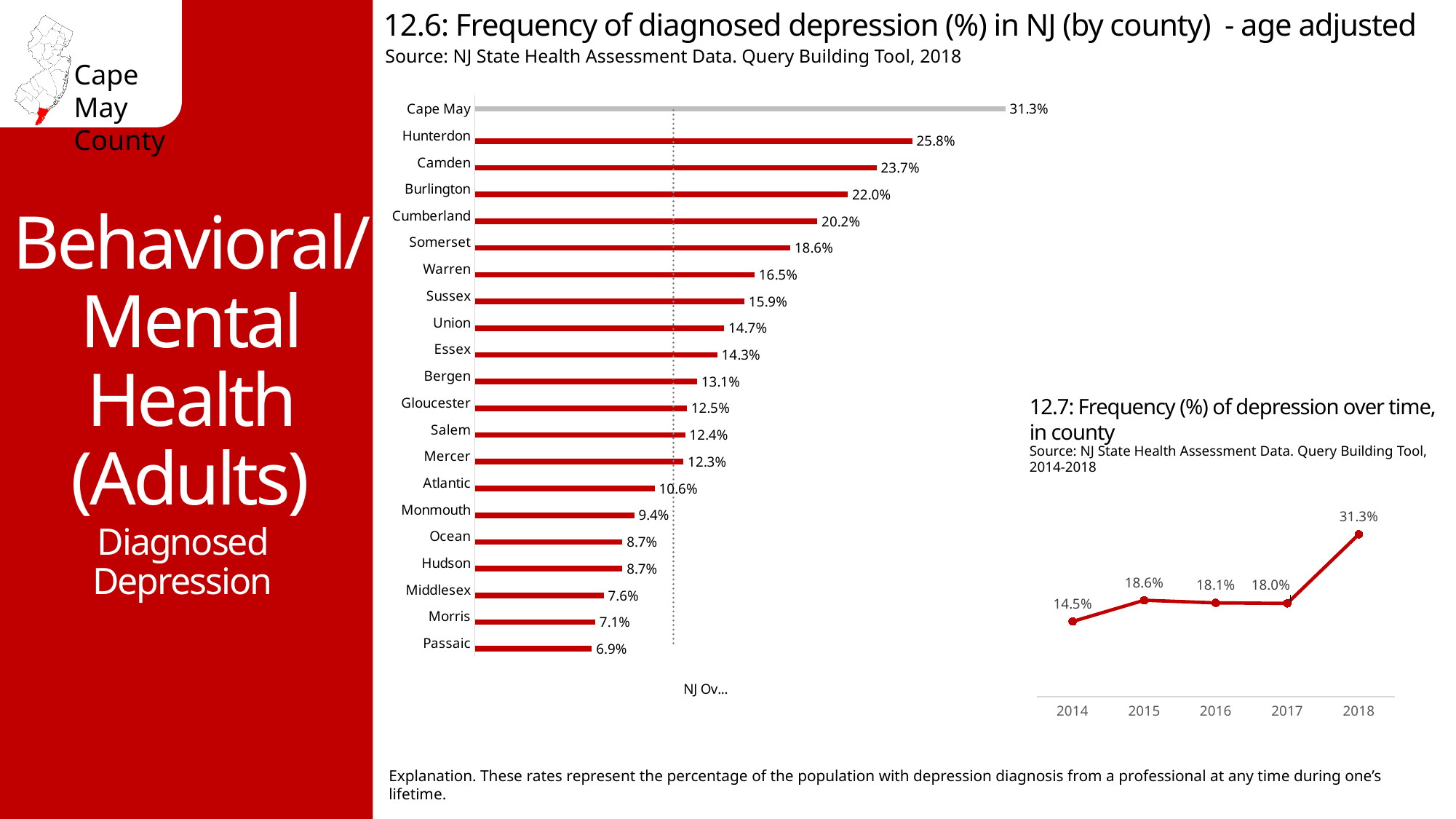
What kind of chart is chart 12.7 (frequency of depression over time)? Line chart In chart 12.7 (frequency of depression over time), what is the difference between 2018 and 2017? 13.3% In chart 12.6 (frequency of diagnosed depression by county), what is the difference between Cape May and Hunterdon? 5.5% In chart 12.6 (frequency of diagnosed depression by county), how many counties are plotted? 21 In chart 12.6 (frequency of diagnosed depression by county), which is larger, Camden or Burlington? Camden In chart 12.6 (frequency of diagnosed depression by county), which county has the highest value? Cape May In chart 12.6 (frequency of diagnosed depression by county), which county has the lowest value? Passaic In chart 12.6 (frequency of diagnosed depression by county), what is the value for Cape May? 31.3% In chart 12.7 (frequency of depression over time), what is the value for 2018? 31.3% In chart 12.7 (frequency of depression over time), what is the value for 2014? 14.5% What kind of chart is chart 12.6 (frequency of diagnosed depression by county)? Bar chart In chart 12.6 (frequency of diagnosed depression by county), what is the value for Somerset? 18.6%